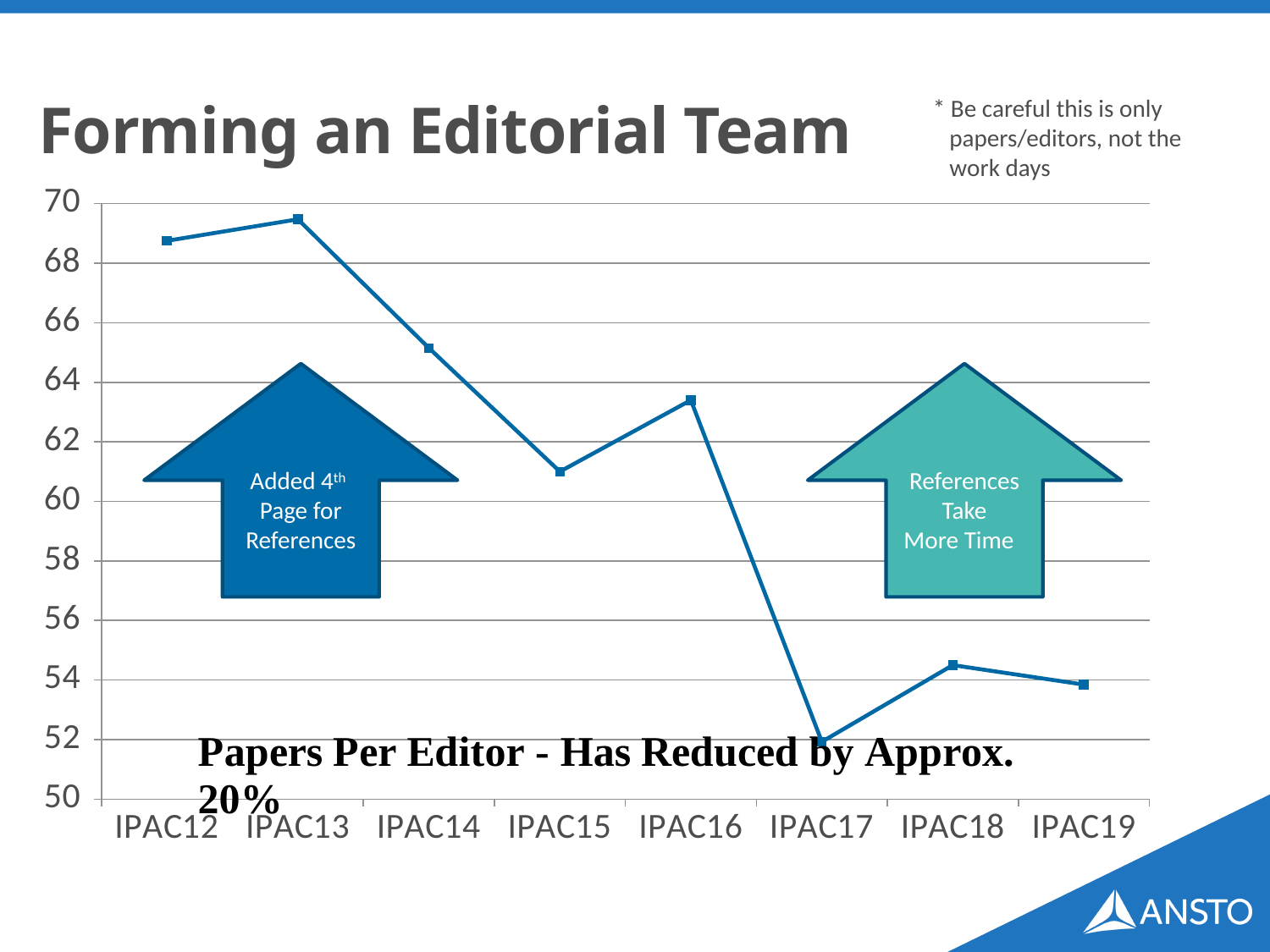
Which has the larger value, IPAC14 or IPAC16? IPAC14 What kind of chart is shown on the slide? line chart Which has the larger value, IPAC15 or IPAC16? IPAC16 Is the value for IPAC13 greater or less than 68? greater Which conference has the lowest papers-per-editor value? IPAC17 Overall, do the values rise or fall from IPAC12 to IPAC19? fall Is the value for IPAC18 greater or less than 56? less Which conference has the highest papers-per-editor value? IPAC13 Is the value for IPAC14 greater or less than 64? greater What does the label on the left arrow inside the chart say? Added 4th Page for References How many IPAC conferences are plotted along the x axis? 8